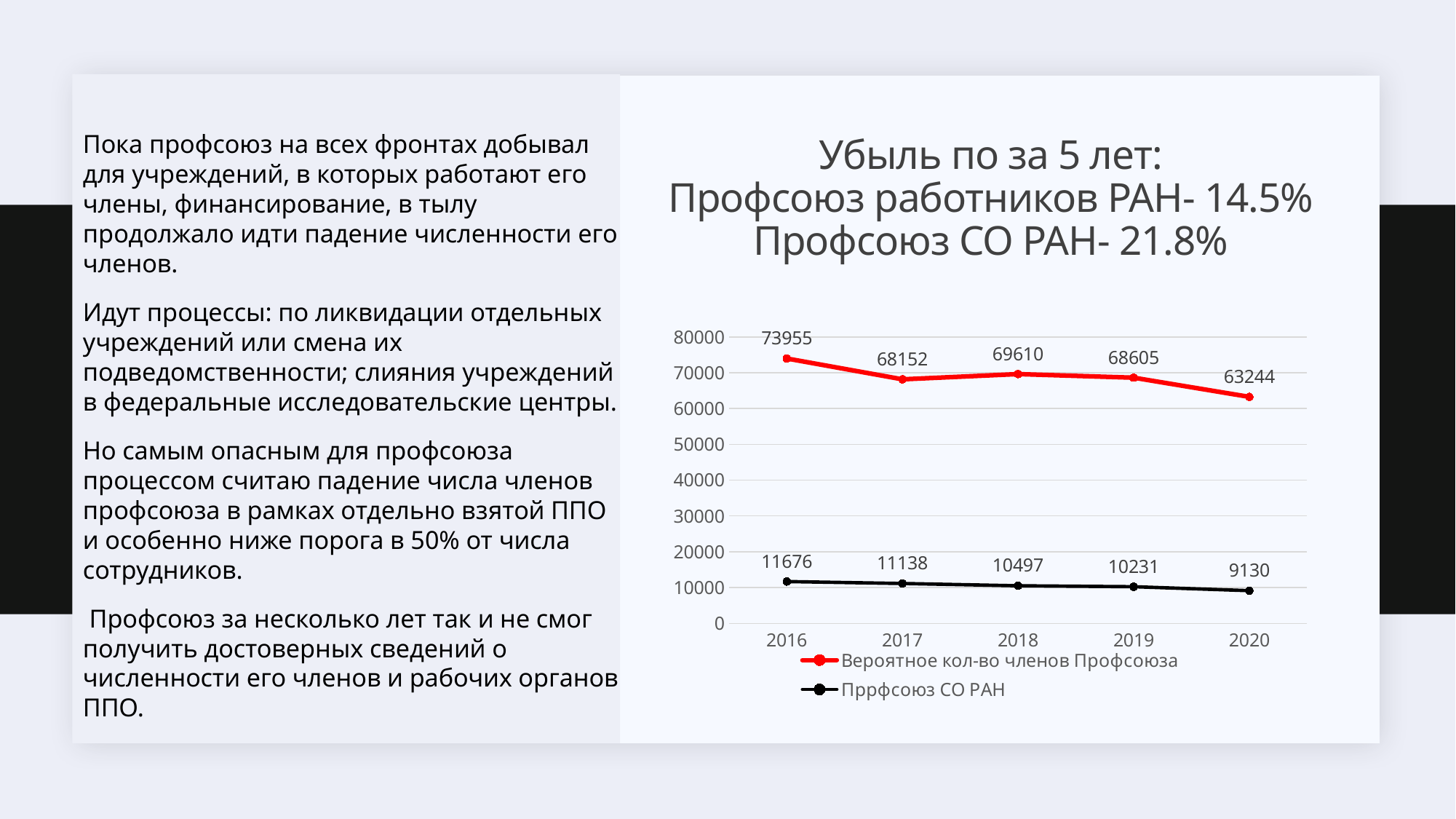
What is the difference between the 2016 and 2020 values of the 'Пррфсоюз СО РАН' series? 2546 What kind of chart is shown on the slide? line chart Does the 'Пррфсоюз СО РАН' series rise or fall from 2016 to 2020? fall In which year is the 'Пррфсоюз СО РАН' series highest? 2016 What is the value of the 'Вероятное кол-во членов Профсоюза' series in 2018? 69610 How many years are plotted on the x axis? 5 What is the difference between the 2016 and 2020 values of the 'Вероятное кол-во членов Профсоюза' series? 10711 How many series does the legend list? 2 What is the value of the 'Пррфсоюз СО РАН' series in 2020? 9130 What is the value of the 'Вероятное кол-во членов Профсоюза' series in 2016? 73955 Which is larger for the 'Вероятное кол-во членов Профсоюза' series: the 2017 value or the 2018 value? 2018 In which year is the 'Вероятное кол-во членов Профсоюза' series lowest? 2020